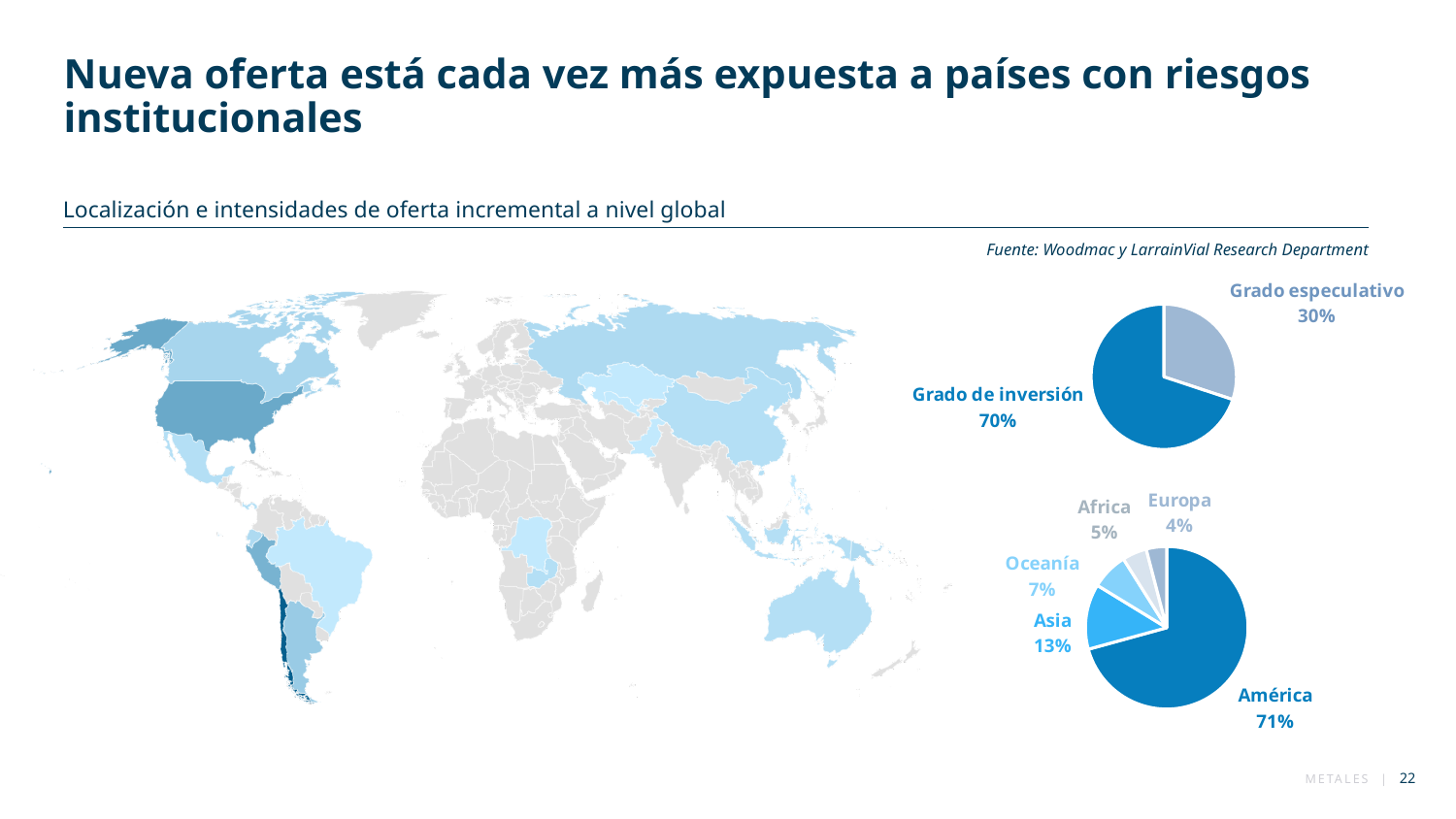
In the bottom pie chart, what share is labelled 'América'? 71% In the top pie chart, what share is labelled 'Grado de inversión'? 70% In the top pie chart, what share is labelled 'Grado especulativo'? 30% In the bottom pie chart, how many regions are shown? 5 In the bottom pie chart, which region has the largest share? América In the bottom pie chart, which region has the smallest share? Europa In the bottom pie chart, what share is labelled 'Asia'? 13% In the bottom pie chart, what is the difference between the shares of Africa and Europa? 1 percentage point In the top pie chart, what is the difference between the 'Grado de inversión' and 'Grado especulativo' shares? 40 percentage points In the bottom pie chart, what share is labelled 'Oceanía'? 7% In the top pie chart, how many slices are there? 2 What kind of chart is used to show the 'Grado de inversión' and 'Grado especulativo' split? Pie chart